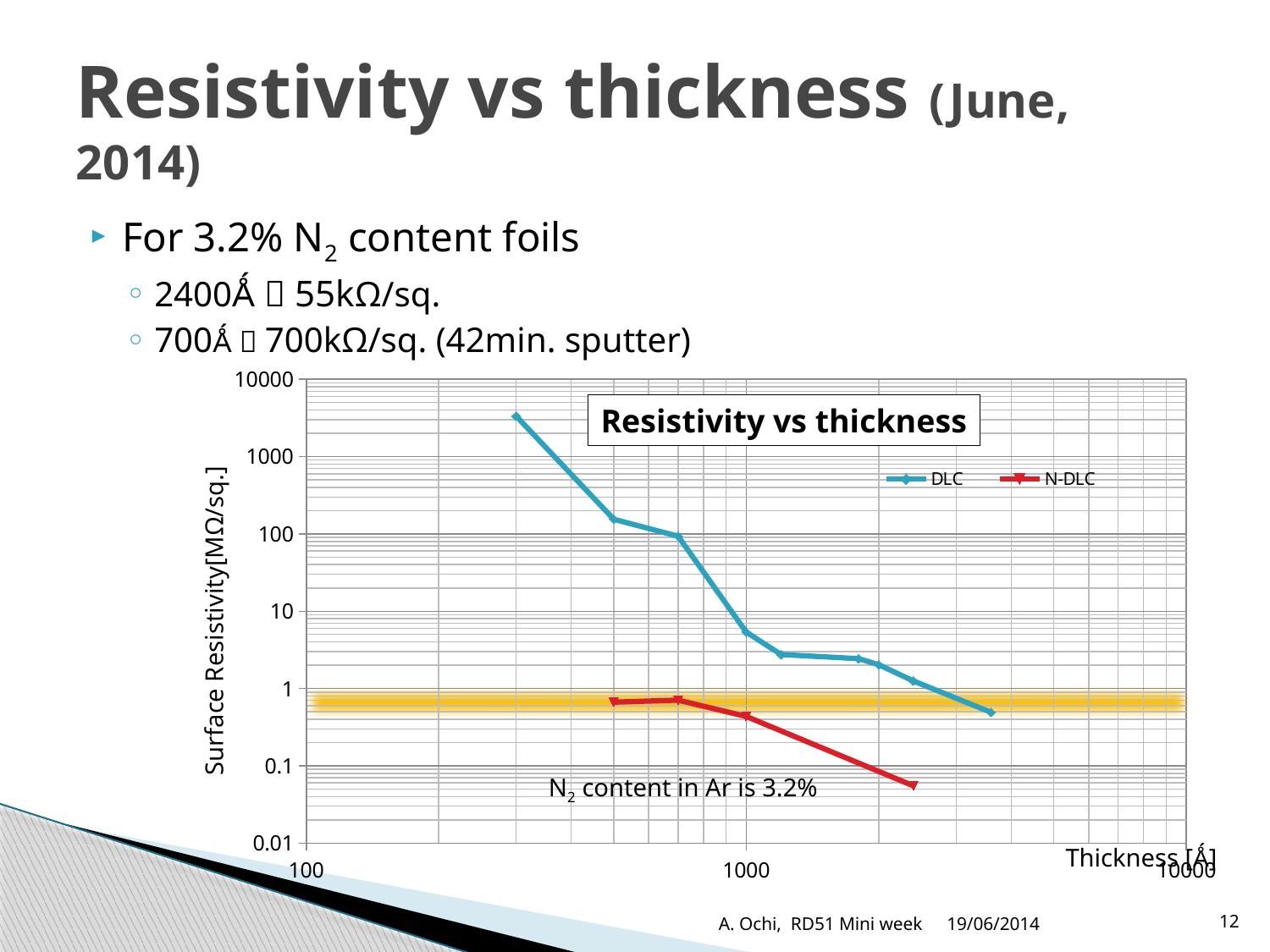
What are the two series named in the chart legend? DLC and N-DLC How many series does the legend of the chart list? 2 What is the title of the chart? Resistivity vs thickness Does the surface resistivity of the N-DLC series rise or fall as thickness increases? fall What kind of chart is shown on the slide? line chart Does the surface resistivity of the DLC series rise or fall as thickness increases? fall Is the highest surface resistivity value of the DLC series greater or less than 1000 MΩ/sq.? greater Is the surface resistivity of the DLC series at a thickness of 1000 Å greater or less than 1 MΩ/sq.? greater Is the lowest surface resistivity value of the N-DLC series greater or less than 0.1 MΩ/sq.? less At a thickness of about 1000 Å, which series has the higher surface resistivity, DLC or N-DLC? DLC Which series reaches the highest surface resistivity on the chart? DLC